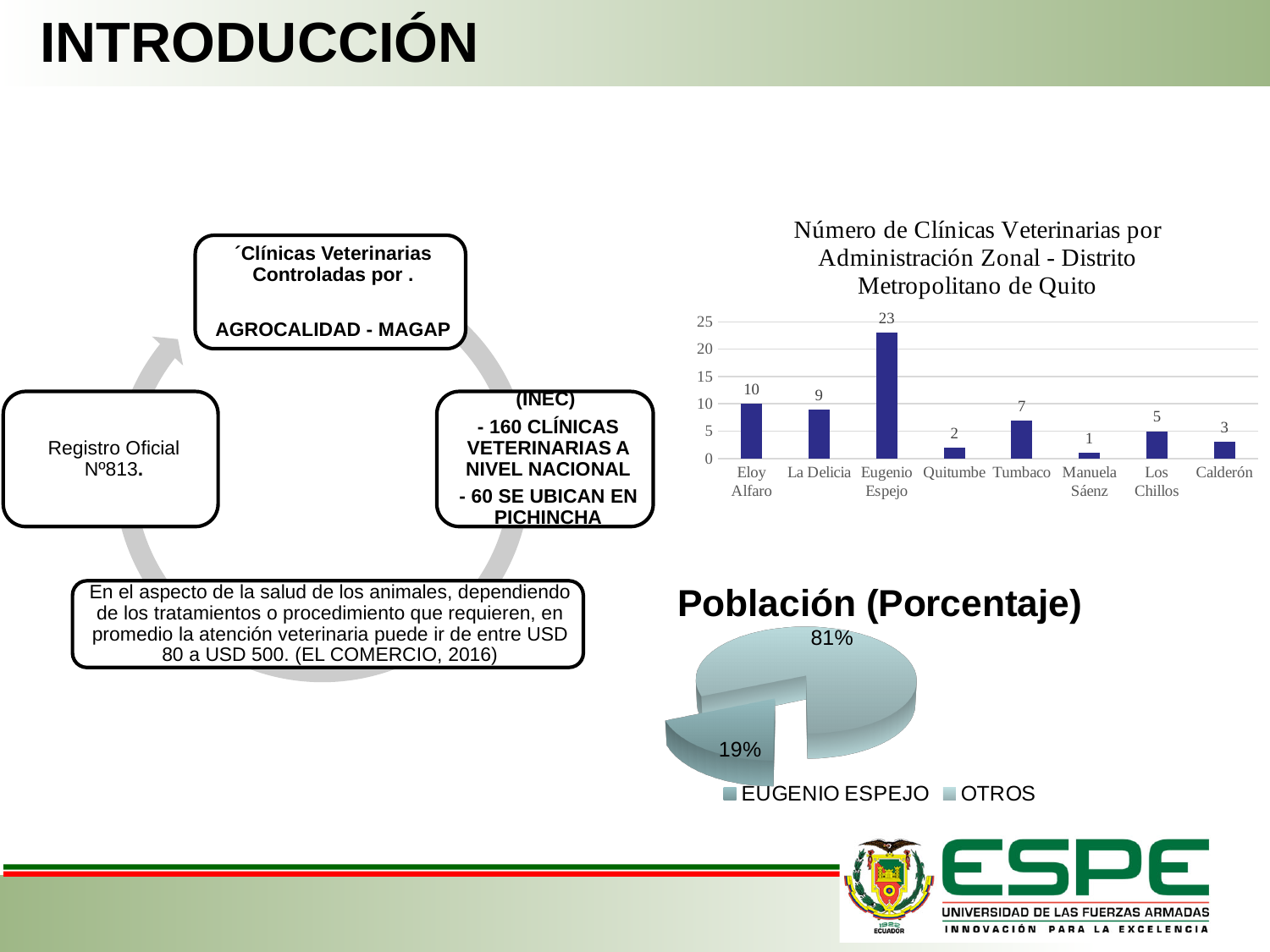
In the bar chart 'Número de Clínicas Veterinarias por Administración Zonal', how many clinics are in Tumbaco? 7 In the bar chart 'Número de Clínicas Veterinarias por Administración Zonal', how many clinics are in Eugenio Espejo? 23 In the pie chart 'Población (Porcentaje)', what percentage is shown on the smaller slice? 19% In the bar chart 'Número de Clínicas Veterinarias por Administración Zonal', what is the difference between Eloy Alfaro and La Delicia? 1 What type of chart is 'Número de Clínicas Veterinarias por Administración Zonal'? Bar chart In the pie chart 'Población (Porcentaje)', what percentage is shown on the larger slice? 81% In the bar chart 'Número de Clínicas Veterinarias por Administración Zonal', what is the difference between Eugenio Espejo and Quitumbe? 21 In the bar chart 'Número de Clínicas Veterinarias por Administración Zonal', which zone has the lowest number of clinics? Manuela Sáenz In the bar chart 'Número de Clínicas Veterinarias por Administración Zonal', how many zones are shown? 8 In the bar chart 'Número de Clínicas Veterinarias por Administración Zonal', which zone has the highest number of clinics? Eugenio Espejo How many entries does the legend of the pie chart 'Población (Porcentaje)' list? 2 In the bar chart 'Número de Clínicas Veterinarias por Administración Zonal', which has more clinics, Los Chillos or Calderón? Los Chillos